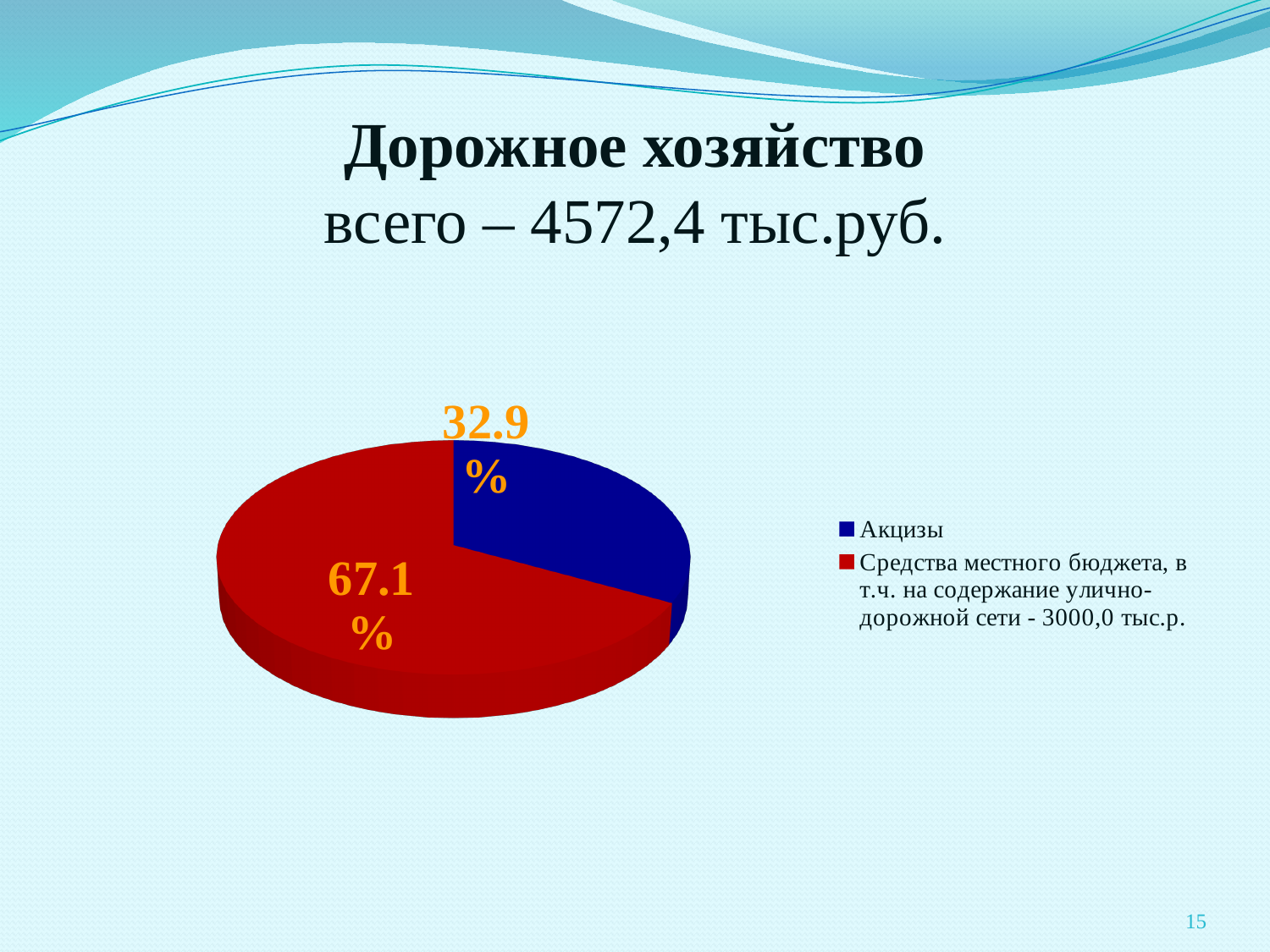
Which slice of the pie is the smallest? Акцизы How many entries does the legend list? 2 What colour is the "Акцизы" slice? blue How many slices does the pie chart have? 2 Which slice of the pie is the largest? Средства местного бюджета What kind of chart is shown on the slide? pie chart What colour is the "Средства местного бюджета" slice? red What share of the pie does "Акцизы" represent? 32.9% What share of the pie does "Средства местного бюджета" represent? 67.1% What is the difference in percentage points between the "Средства местного бюджета" slice and the "Акцизы" slice? 34.2 Which is larger: the share for "Акцизы" or the share for "Средства местного бюджета"? Средства местного бюджета